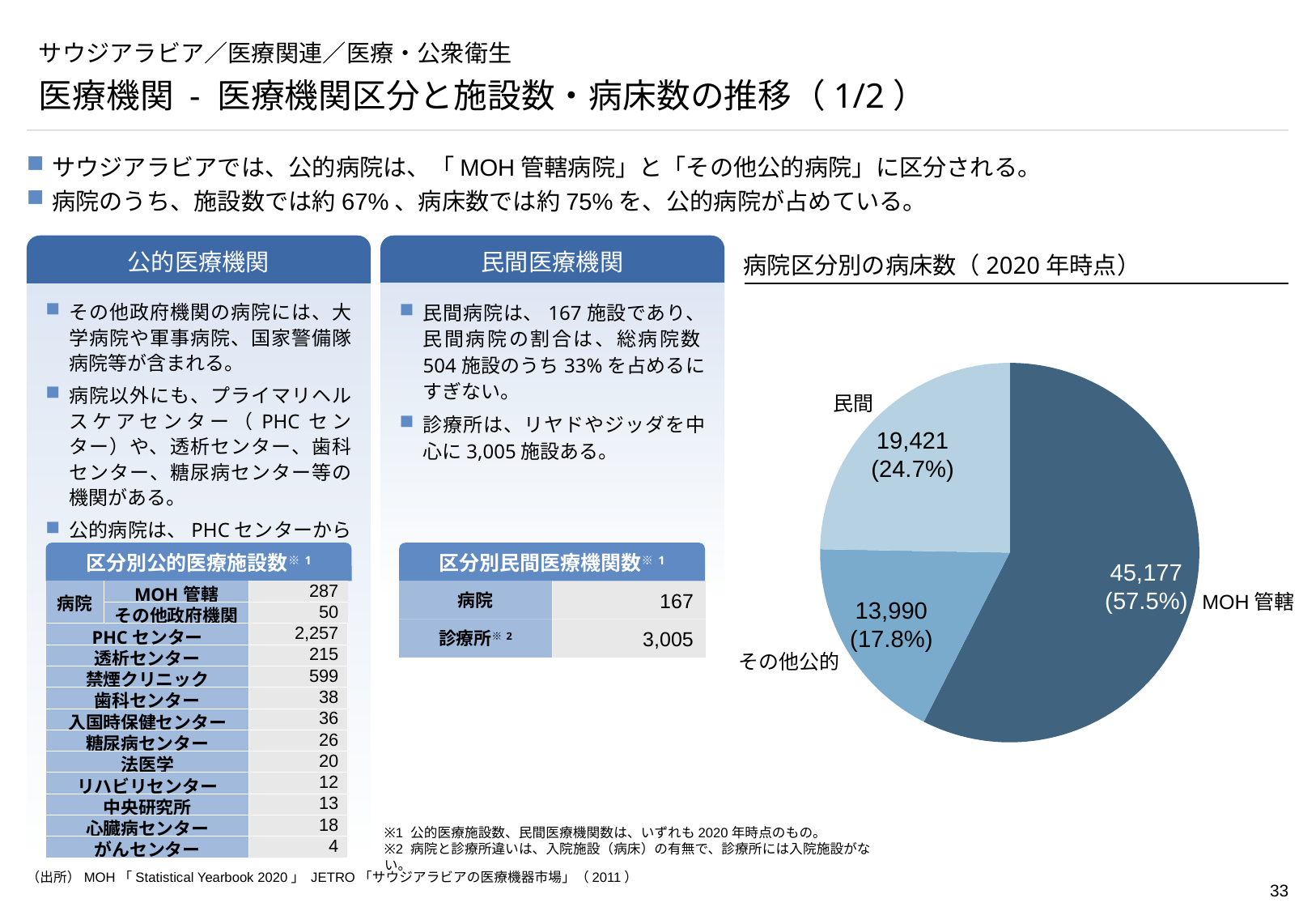
「病院区分別の病床数（2020年時点）」のグラフで、民間とその他公的の病床数の差はいくつですか？ 5,431 「病院区分別の病床数（2020年時点）」のグラフには、いくつの区分（スライス）がありますか？ 3 「病院区分別の病床数（2020年時点）」のグラフで、病床数が最も多い区分はどれですか？ MOH管轄 「病院区分別の病床数（2020年時点）」のグラフで、民間の病床数はいくつですか？ 19,421 「病院区分別の病床数（2020年時点）」のグラフは、どの種類のグラフですか？ 円グラフ 「病院区分別の病床数（2020年時点）」のグラフで、MOH管轄と民間の病床数の差はいくつですか？ 25,756 「病院区分別の病床数（2020年時点）」のグラフで、MOH管轄の病床数はいくつですか？ 45,177 「病院区分別の病床数（2020年時点）」のグラフで、民間の病床数が全体に占める割合は何%ですか？ 24.7% 「病院区分別の病床数（2020年時点）」のグラフで、その他公的の病床数はいくつですか？ 13,990 「病院区分別の病床数（2020年時点）」のグラフで、民間とその他公的では、どちらの病床数が多いですか？ 民間 「病院区分別の病床数（2020年時点）」のグラフで、病床数が最も少ない区分はどれですか？ その他公的 「病院区分別の病床数（2020年時点）」のグラフで、その他公的の病床数が全体に占める割合は何%ですか？ 17.8%